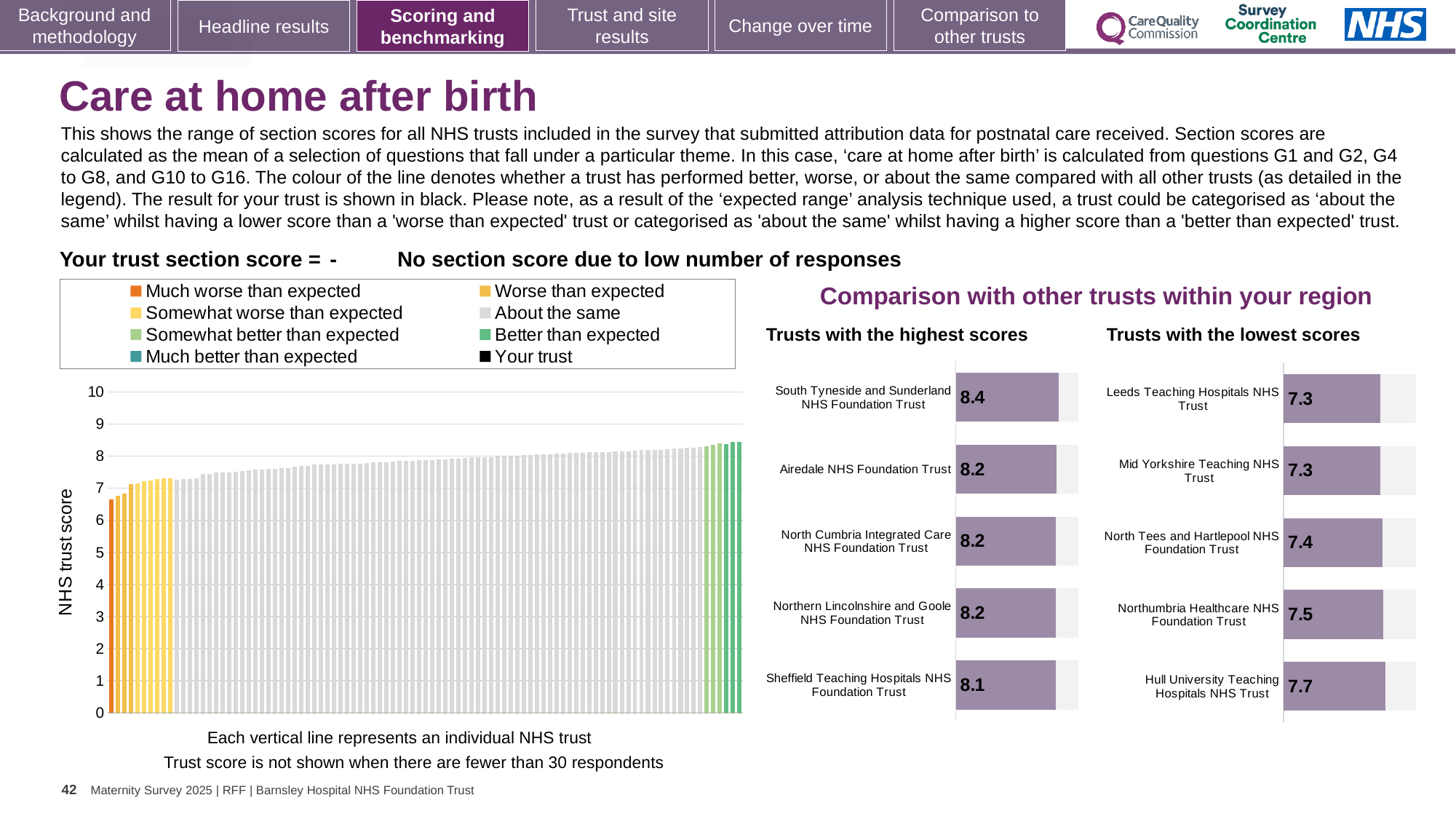
In the 'Trusts with the lowest scores' chart, what is the score for Hull University Teaching Hospitals NHS Trust? 7.7 In the 'Trusts with the highest scores' chart, what is the difference between the scores of South Tyneside and Sunderland NHS Foundation Trust and Sheffield Teaching Hospitals NHS Foundation Trust? 0.3 In the 'Trusts with the highest scores' chart, what is the score for South Tyneside and Sunderland NHS Foundation Trust? 8.4 In the 'Trusts with the lowest scores' chart, what is the score for North Tees and Hartlepool NHS Foundation Trust? 7.4 In the 'NHS trust score' chart on the left, do the values rise or fall from left to right? Rise What kind of chart is the 'NHS trust score' chart on the left of the slide? Bar chart How many entries does the legend above the 'NHS trust score' chart list? 8 How many trusts are listed in the 'Trusts with the lowest scores' chart? 5 In the 'Trusts with the lowest scores' chart, which trust has the highest score? Hull University Teaching Hospitals NHS Trust In the 'Trusts with the highest scores' chart, what is the score for Sheffield Teaching Hospitals NHS Foundation Trust? 8.1 In the 'Trusts with the highest scores' chart, which trust has the highest score? South Tyneside and Sunderland NHS Foundation Trust In the 'Trusts with the lowest scores' chart, which is larger: the score for Northumbria Healthcare NHS Foundation Trust or Leeds Teaching Hospitals NHS Trust? Northumbria Healthcare NHS Foundation Trust